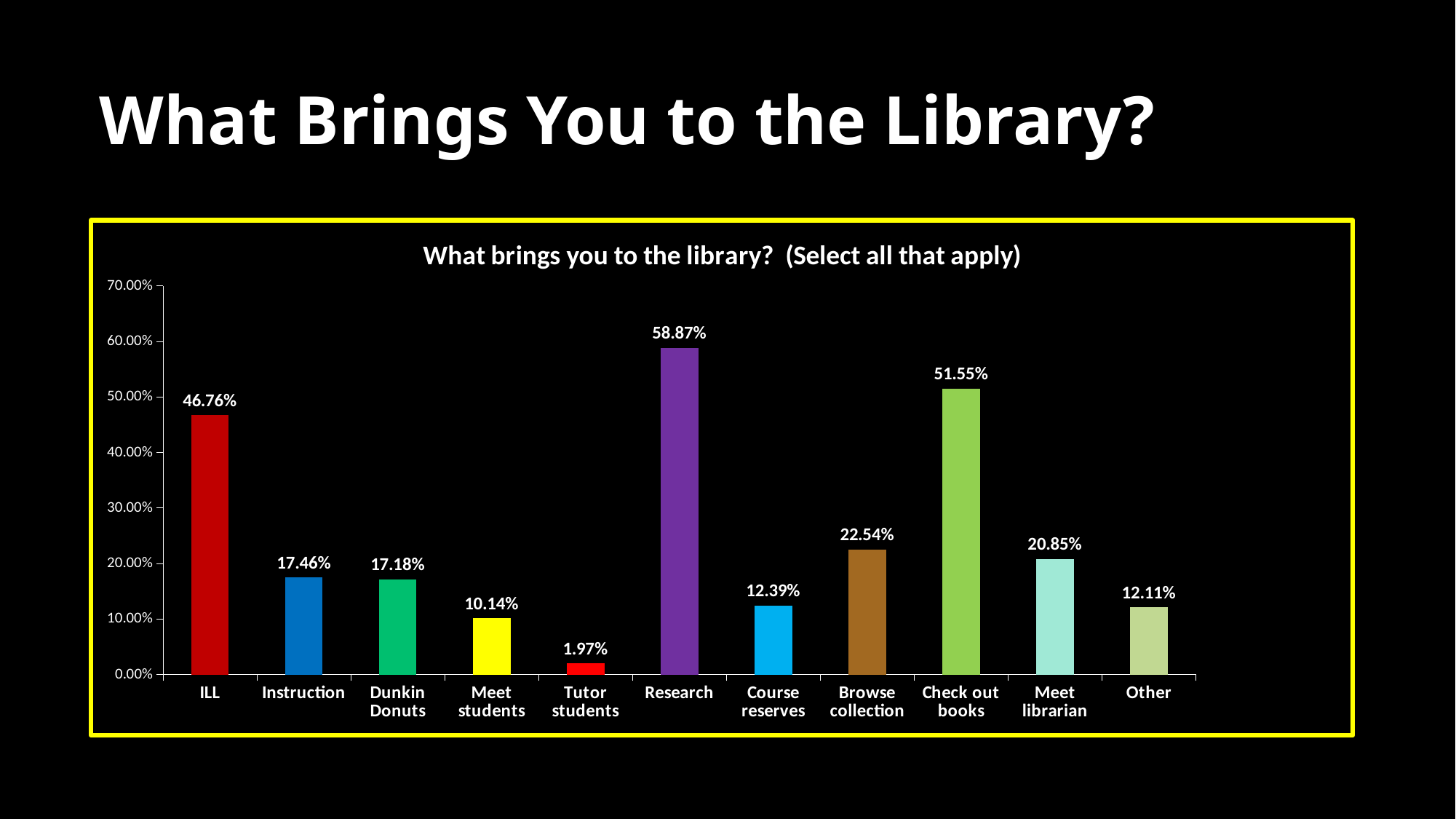
Which is larger, the value for Browse collection or the value for Meet librarian? Browse collection What is the value for Research? 58.87% Which category has the lowest value? Tutor students What is the title of the chart? What brings you to the library? (Select all that apply) What is the value for Meet librarian? 20.85% Is the value for ILL greater or less than 40.00%? greater What is the difference between the values for Research and Check out books? 7.32% What is the value for Check out books? 51.55% What kind of chart is shown? bar chart How many categories are shown on the x axis? 11 Which category has the highest value? Research What is the value for Tutor students? 1.97%